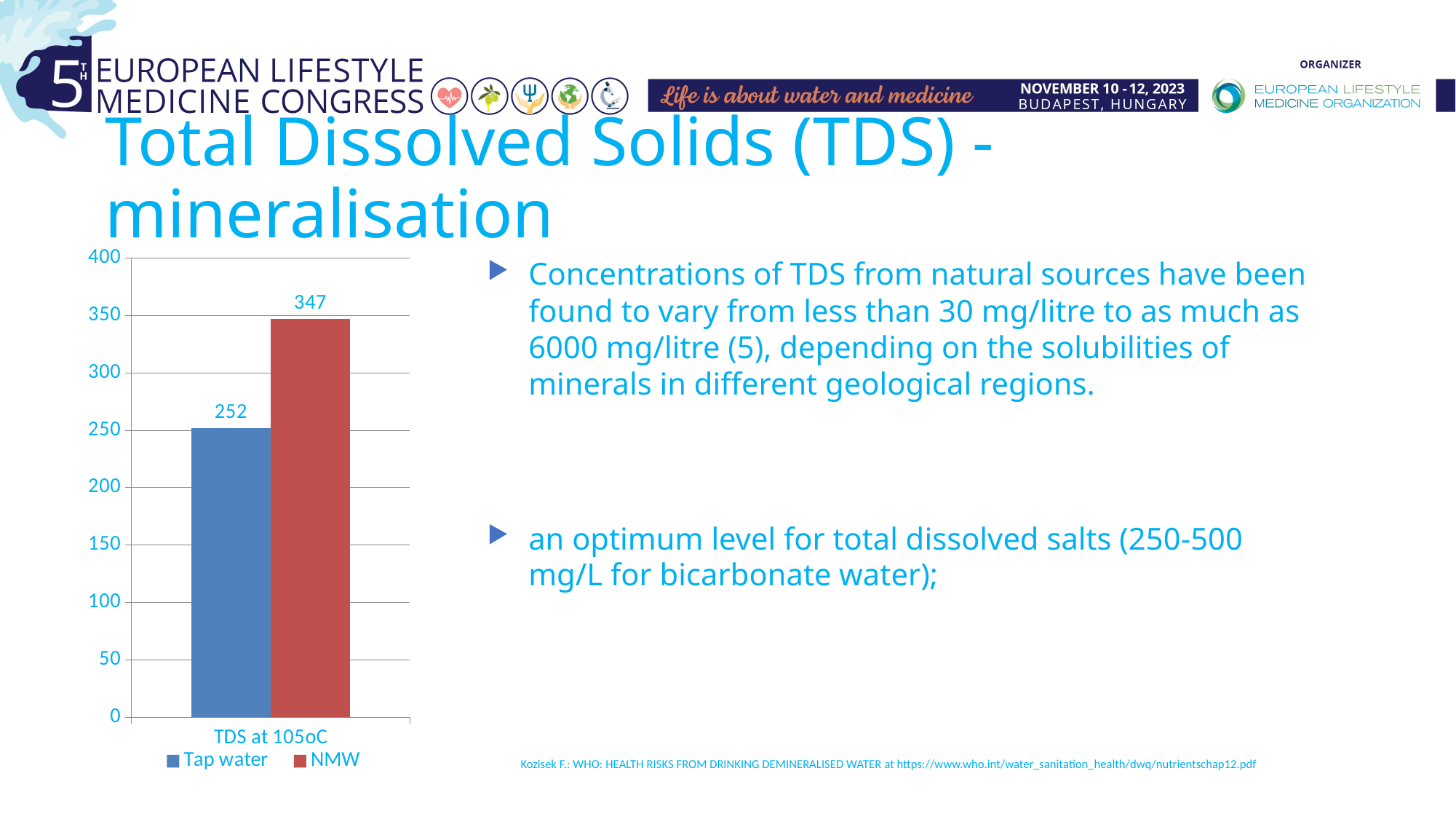
What is the TDS value for Tap water? 252 How many series does the legend list? 2 What is the category label on the x axis of the chart? TDS at 105oC Which series has the higher TDS value, Tap water or NMW? NMW Which series has the lowest TDS value? Tap water Is the value for NMW greater or less than 300? greater What colour is the bar for NMW? red What kind of chart is shown on the slide? bar chart What is the difference between the NMW and Tap water TDS values? 95 What is the TDS value for NMW? 347 Is the value for Tap water greater or less than 300? less What is the maximum value shown on the y axis of the chart? 400